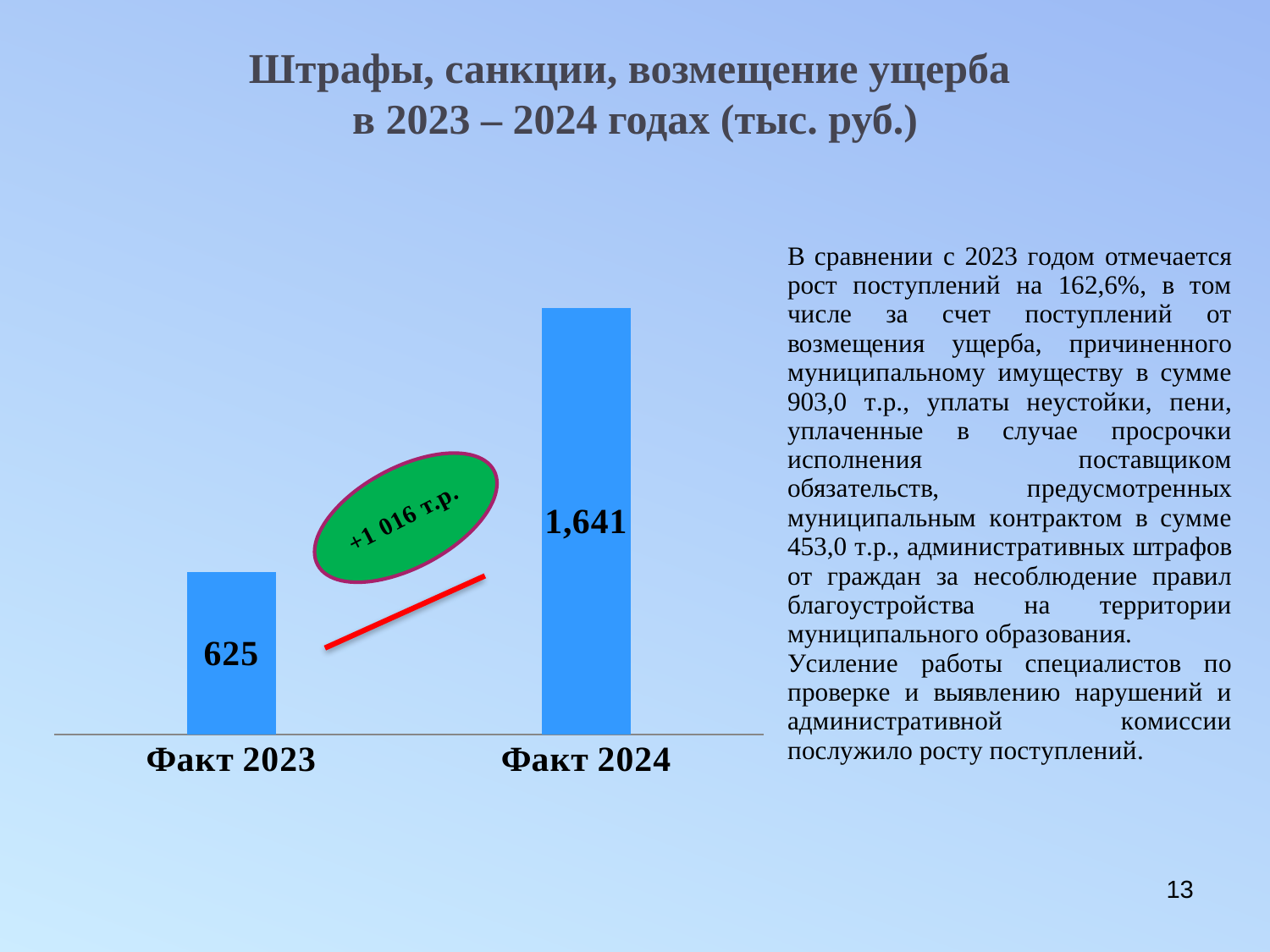
What is the title of the chart? Штрафы, санкции, возмещение ущерба в 2023 – 2024 годах (тыс. руб.) What kind of chart is shown on the slide? bar chart What is the difference between the values for Факт 2024 and Факт 2023? 1,016 How many categories are shown in the chart? 2 What is the value for Факт 2024? 1,641 Which category has the lowest value? Факт 2023 Do the values rise or fall from Факт 2023 to Факт 2024? rise Which category has the highest value? Факт 2024 What is the value for Факт 2023? 625 What increase is written in the green oval annotation on the chart? +1 016 т.р. Which is larger, the value for Факт 2023 or the value for Факт 2024? Факт 2024